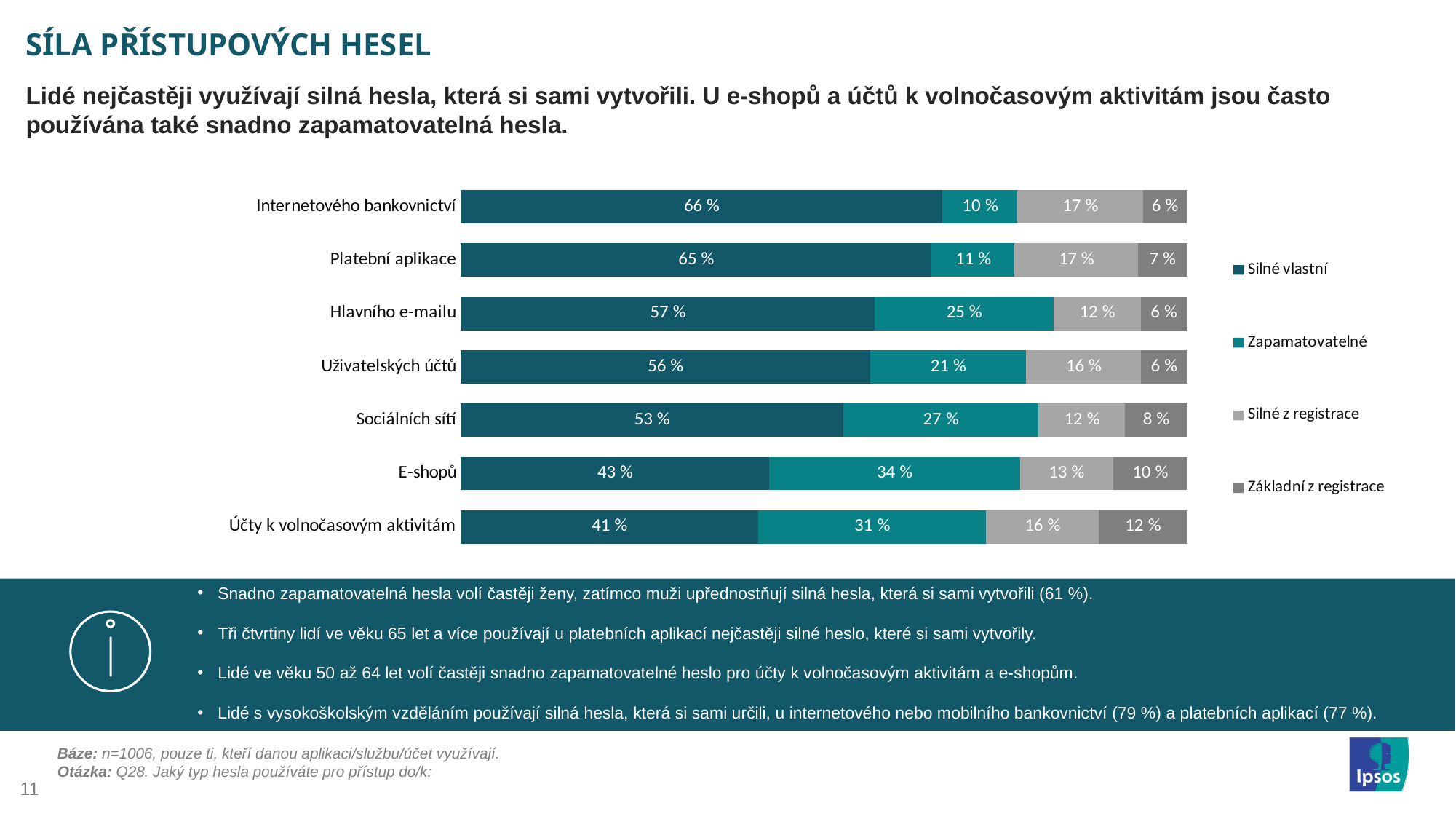
Which category has the lowest value for 'Silné vlastní'? Účty k volnočasovým aktivitám What is the value of 'Silné vlastní' for 'Internetového bankovnictví'? 66 % Which category has the highest value for 'Základní z registrace'? Účty k volnočasovým aktivitám What is the value of 'Silné z registrace' for 'Uživatelských účtů'? 16 % What is the value of 'Zapamatovatelné' for 'E-shopů'? 34 % What kind of chart is shown on the slide? Stacked bar chart What is the total of the stacked bar for 'Platební aplikace'? 100 % What is the difference between the 'Silné vlastní' values for 'Hlavního e-mailu' and 'Sociálních sítí'? 4 % Which has a larger 'Zapamatovatelné' value: 'Sociálních sítí' or 'Hlavního e-mailu'? Sociálních sítí Which category has the highest value for 'Silné vlastní'? Internetového bankovnictví How many series does the legend list? 4 How many categories are shown in the chart? 7